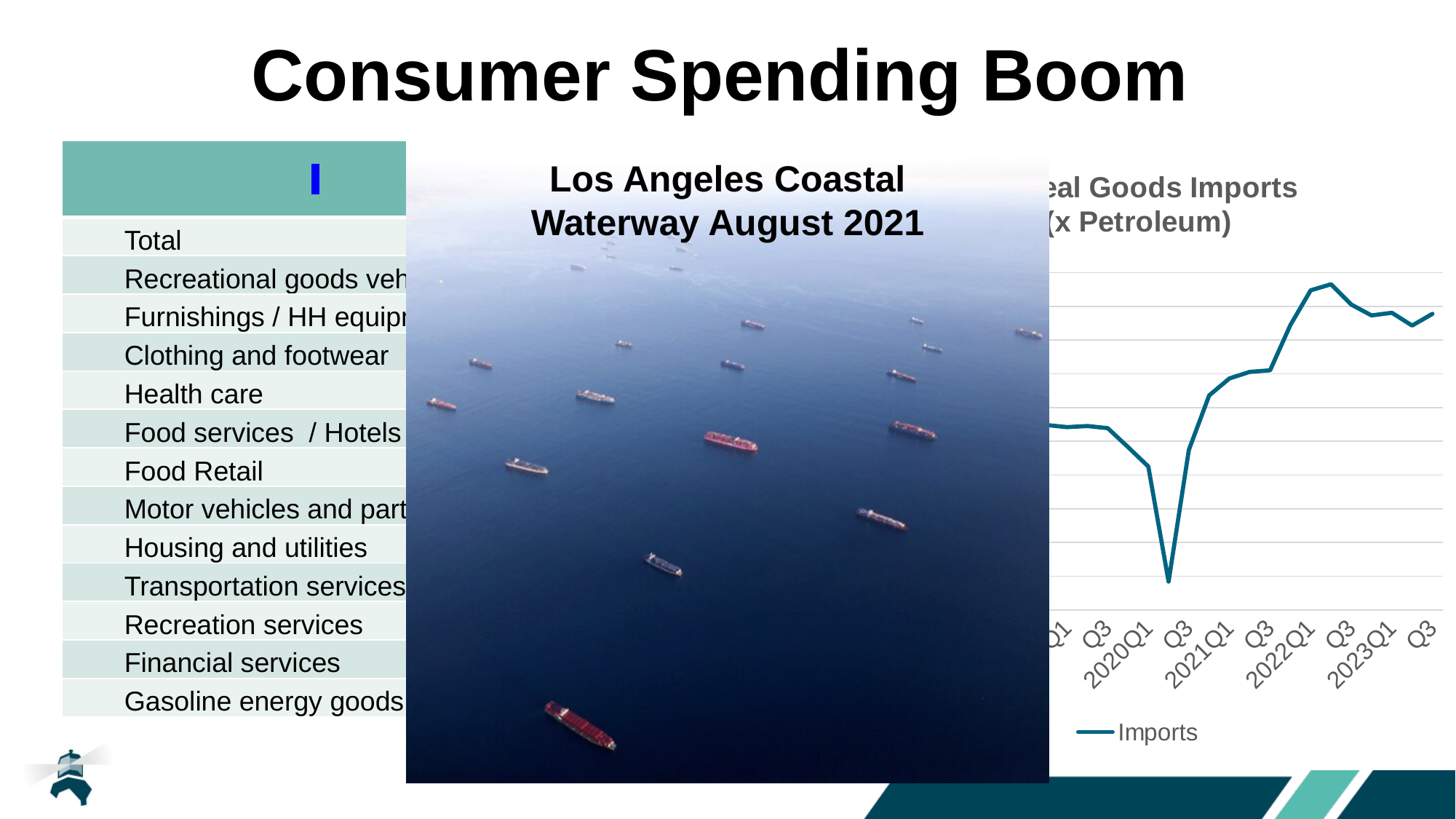
In the Goods Imports (x Petroleum) chart, is the Imports value at the end of the series (2023Q3) higher or lower than at the start of the series? higher In the Goods Imports (x Petroleum) chart, which is higher: the Imports value at 2021Q1 or at 2022Q1? 2022Q1 How many series does the legend of the Goods Imports (x Petroleum) chart list? 1 What kind of chart is the Goods Imports (x Petroleum) chart on the right? line chart In the Goods Imports (x Petroleum) chart, does the Imports line rise or fall sharply immediately after 2020Q1? fall What is the name of the series shown in the legend of the Goods Imports (x Petroleum) chart? Imports According to the title of the line chart on the right, what is excluded from the goods imports? Petroleum In the Goods Imports (x Petroleum) chart, does the Imports line rise or fall between 2021Q1 and 2022Q1? rise In the Goods Imports (x Petroleum) chart, is the Imports value at 2023Q3 higher or lower than at 2020Q1? higher